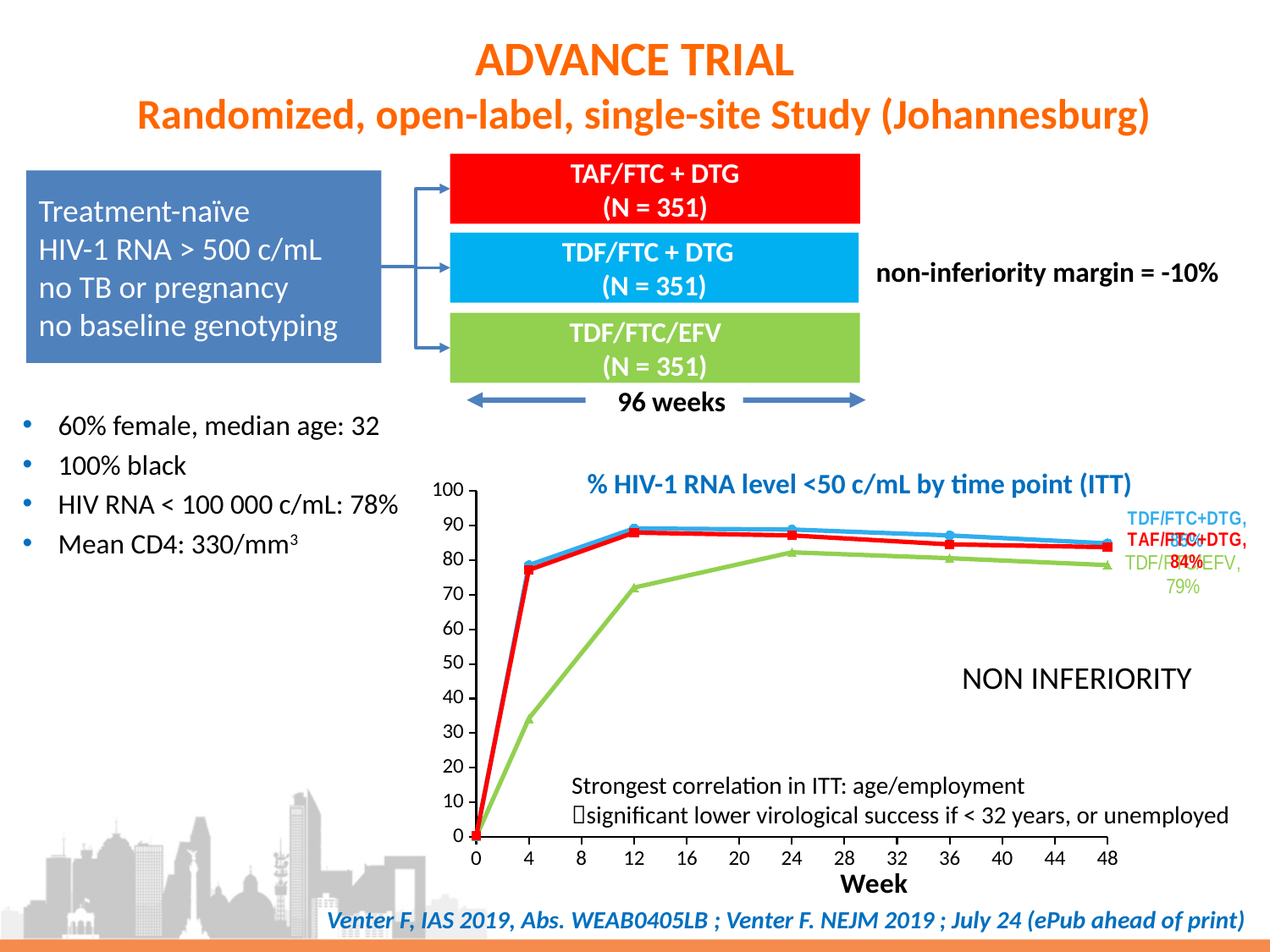
Is the value for TDF/FTC/EFV at week 12 greater or less than 80? less What is the title of the chart? % HIV-1 RNA level <50 c/mL by time point (ITT) What is the difference between the week 48 values for TAF/FTC+DTG and TDF/FTC/EFV? 5 percentage points What kind of chart is shown on the slide? line chart Is the value for TAF/FTC+DTG at week 4 greater or less than 70? greater Does the TDF/FTC/EFV line rise or fall between week 0 and week 24? rises What is the value for TAF/FTC+DTG at week 48? 84% Which series has the lowest value at week 48? TDF/FTC/EFV Is the value for TDF/FTC/EFV at week 4 greater or less than 40? less How many series are plotted on the chart? 3 What is the value for TDF/FTC/EFV at week 48? 79% At week 48, which is larger: TAF/FTC+DTG or TDF/FTC/EFV? TAF/FTC+DTG